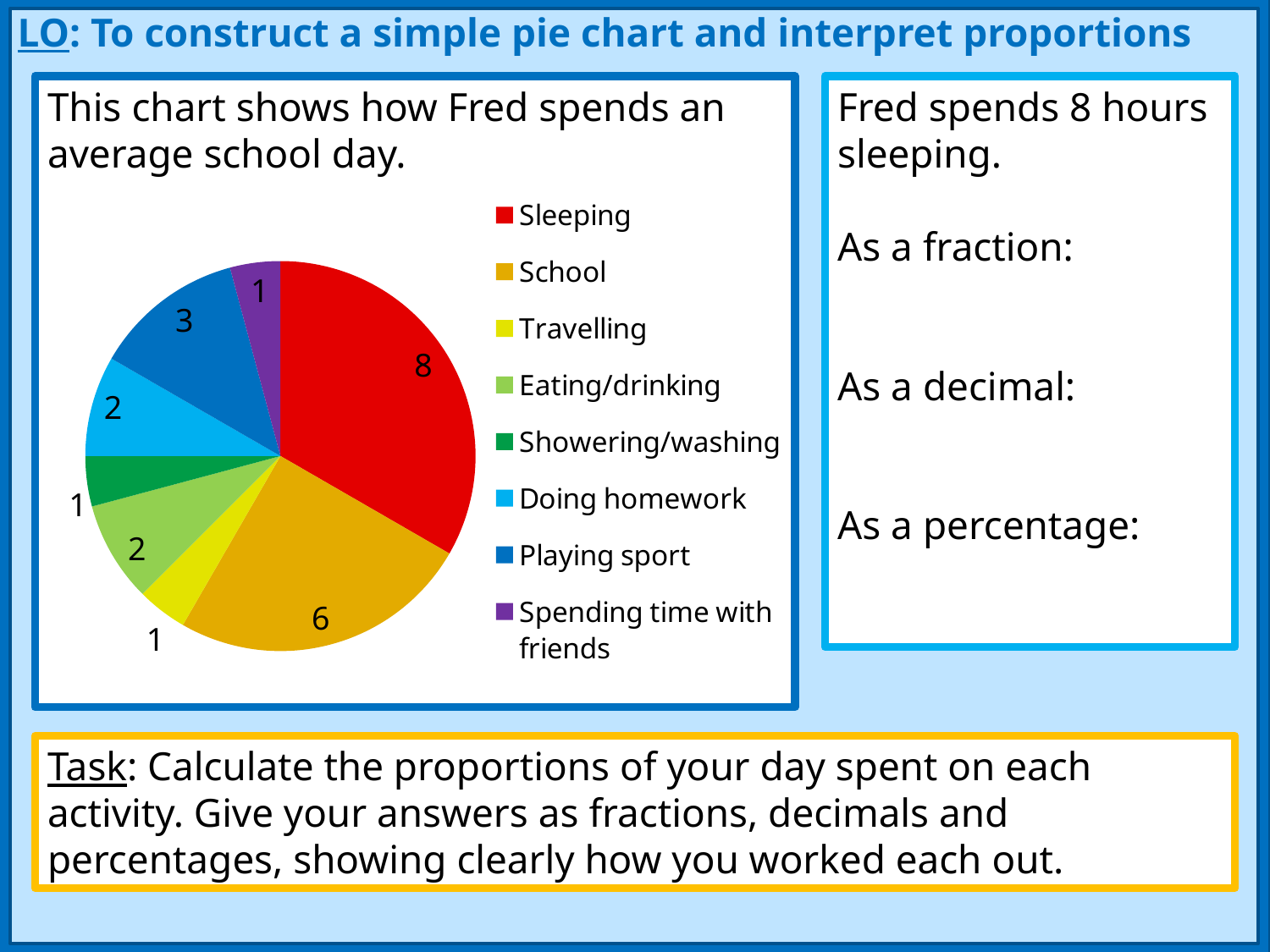
Which activity has the largest slice of the pie chart? Sleeping What percentage of the whole pie does the Playing sport slice represent? 12.5% What value is shown for School on the pie chart? 6 What colour is the Sleeping slice in the pie chart? Red Which is larger, the value for Playing sport or the value for Doing homework? Playing sport What value is shown for Playing sport on the pie chart? 3 What is the total of all the values shown on the pie chart? 24 What fraction of the whole pie does the School slice represent? 1/4 How many categories does the legend of the pie chart list? 8 What is the difference between the values for Sleeping and School? 2 What type of chart is shown on the slide? Pie chart How many hours does Fred spend sleeping according to the pie chart? 8